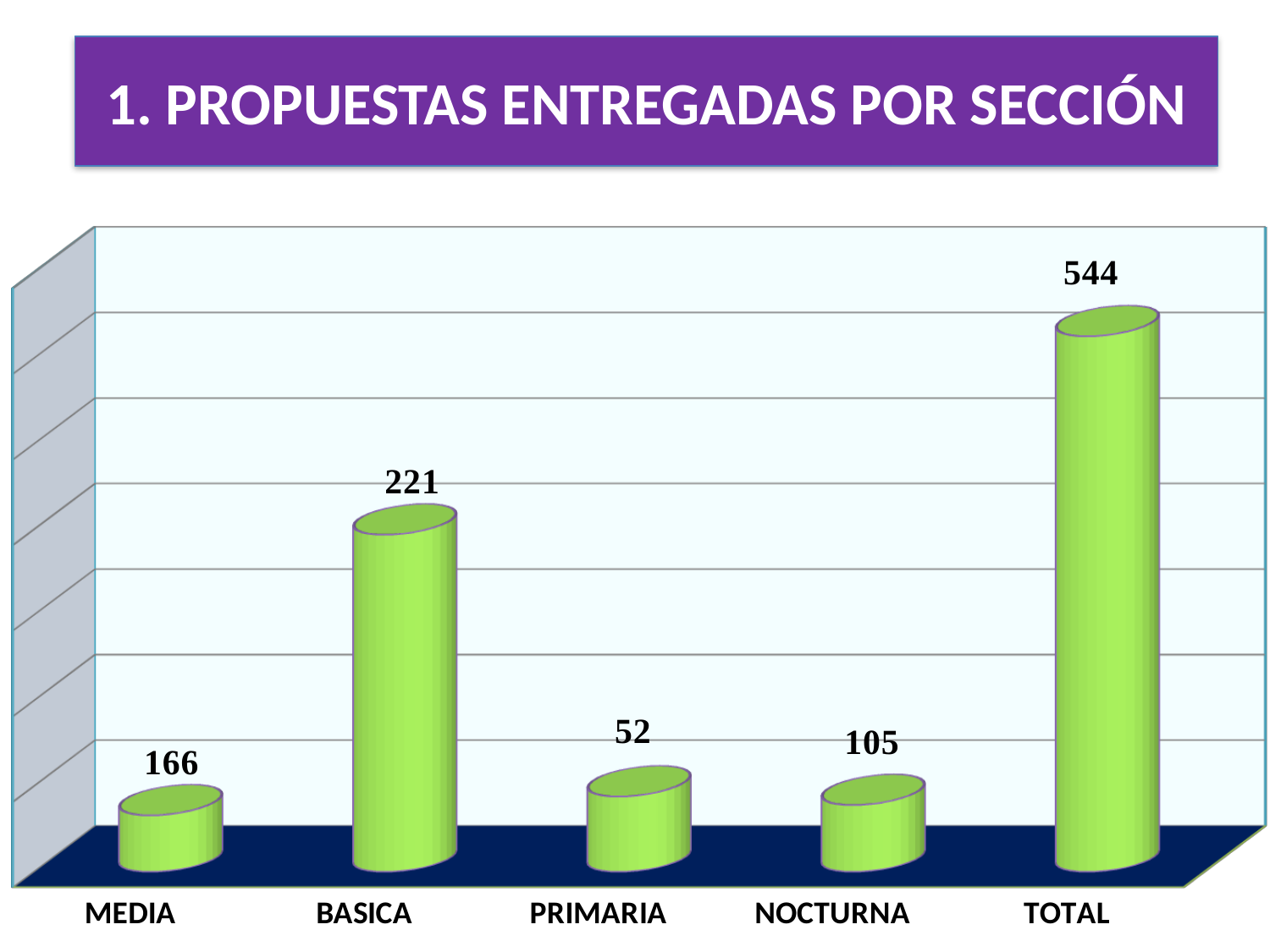
What is the value for BASICA? 221 What is the difference between the values for BASICA and MEDIA? 55 What kind of chart is shown on the slide? bar chart What is the value for NOCTURNA? 105 Which is larger, the value for NOCTURNA or the value for PRIMARIA? NOCTURNA What is the value for TOTAL? 544 What is the title of the slide? 1. PROPUESTAS ENTREGADAS POR SECCIÓN How many categories are shown on the x axis? 5 Which category has the lowest value? PRIMARIA What is the value for MEDIA? 166 What is the value for PRIMARIA? 52 Which category has the highest value? TOTAL